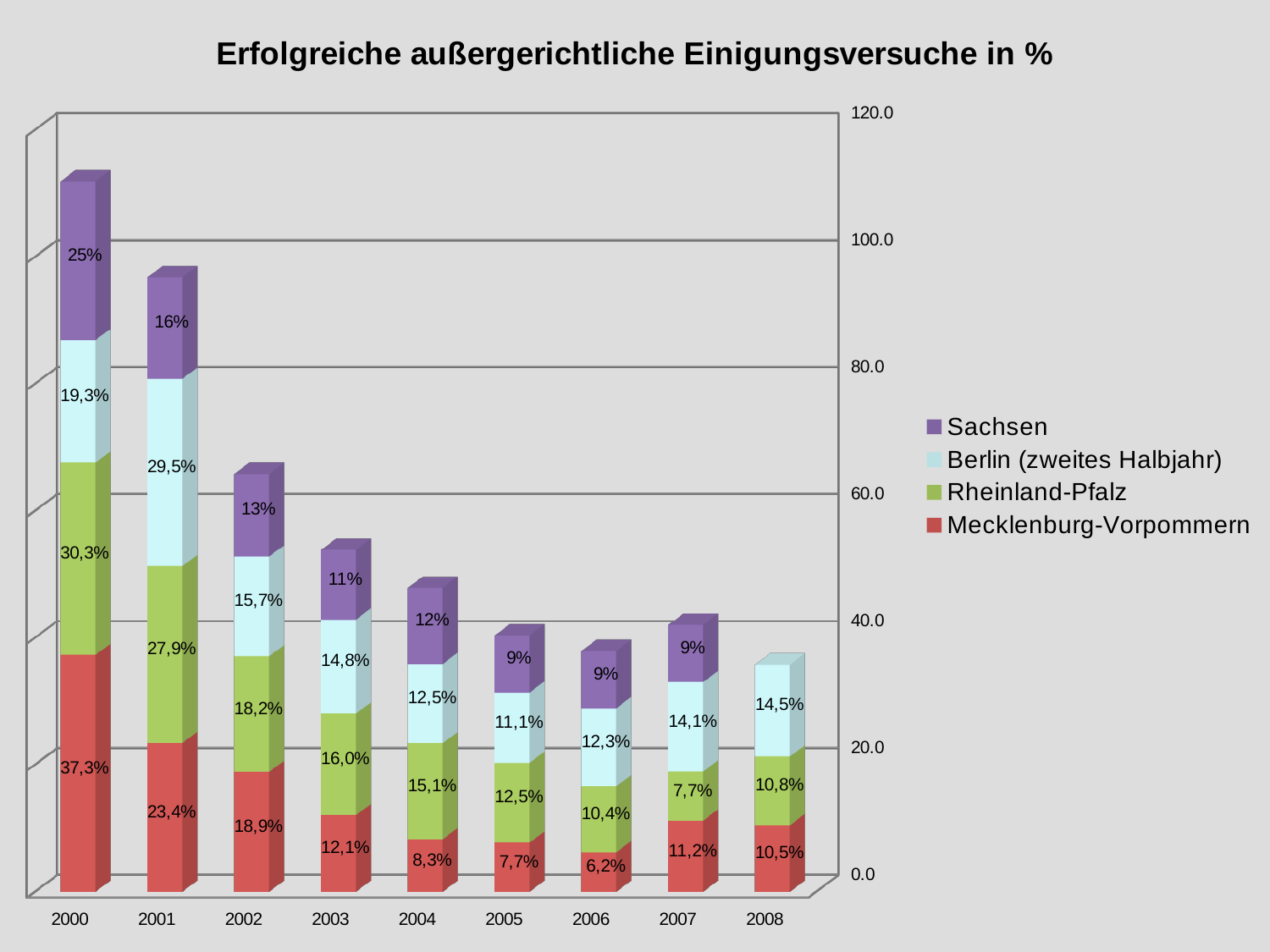
How many years are shown on the x axis? 9 What is the total of the stacked bar for 2008? 35,8% What is the value for Sachsen in 2004? 12% Does the value for Mecklenburg-Vorpommern rise or fall from 2000 to 2006? Fall In which year is the value for Mecklenburg-Vorpommern highest? 2000 How many series does the legend list? 4 What is the value for Mecklenburg-Vorpommern in 2000? 37,3% In 2007, which is larger: the value for Mecklenburg-Vorpommern or for Rheinland-Pfalz? Mecklenburg-Vorpommern What kind of chart is shown on the slide? Stacked bar chart What is the value for Berlin (zweites Halbjahr) in 2001? 29,5% What is the difference between the Rheinland-Pfalz values for 2000 and 2001? 2,4 percentage points In which year is the value for Mecklenburg-Vorpommern lowest? 2006